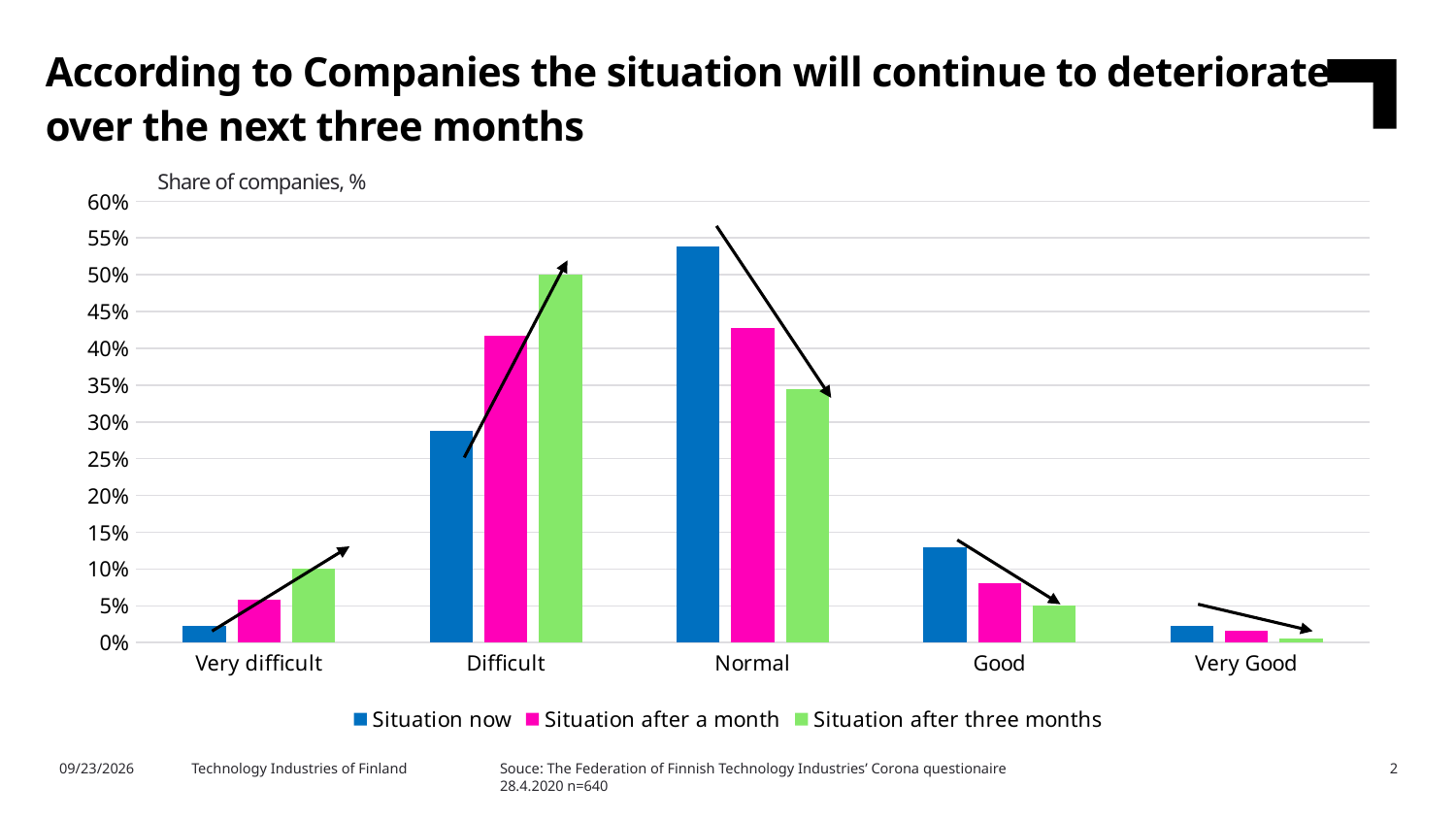
Which category has the lowest value for 'Situation after three months'? Very Good Which category has the highest value for 'Situation after three months'? Difficult For the 'Difficult' category, which is larger: 'Situation now' or 'Situation after three months'? Situation after three months For the 'Normal' category, which is larger: 'Situation now' or 'Situation after three months'? Situation now Is the value for 'Situation after three months' in the 'Good' category greater or less than 10%? less For the 'Normal' category, do the values rise or fall from 'Situation now' to 'Situation after three months'? fall How many series does the legend list? 3 What kind of chart is shown on the slide? Bar chart Is the value for 'Situation now' in the 'Normal' category greater or less than 50%? greater Which category has the highest value for 'Situation now'? Normal How many categories are shown on the x axis? 5 What label is shown above the vertical axis of the chart? Share of companies, %